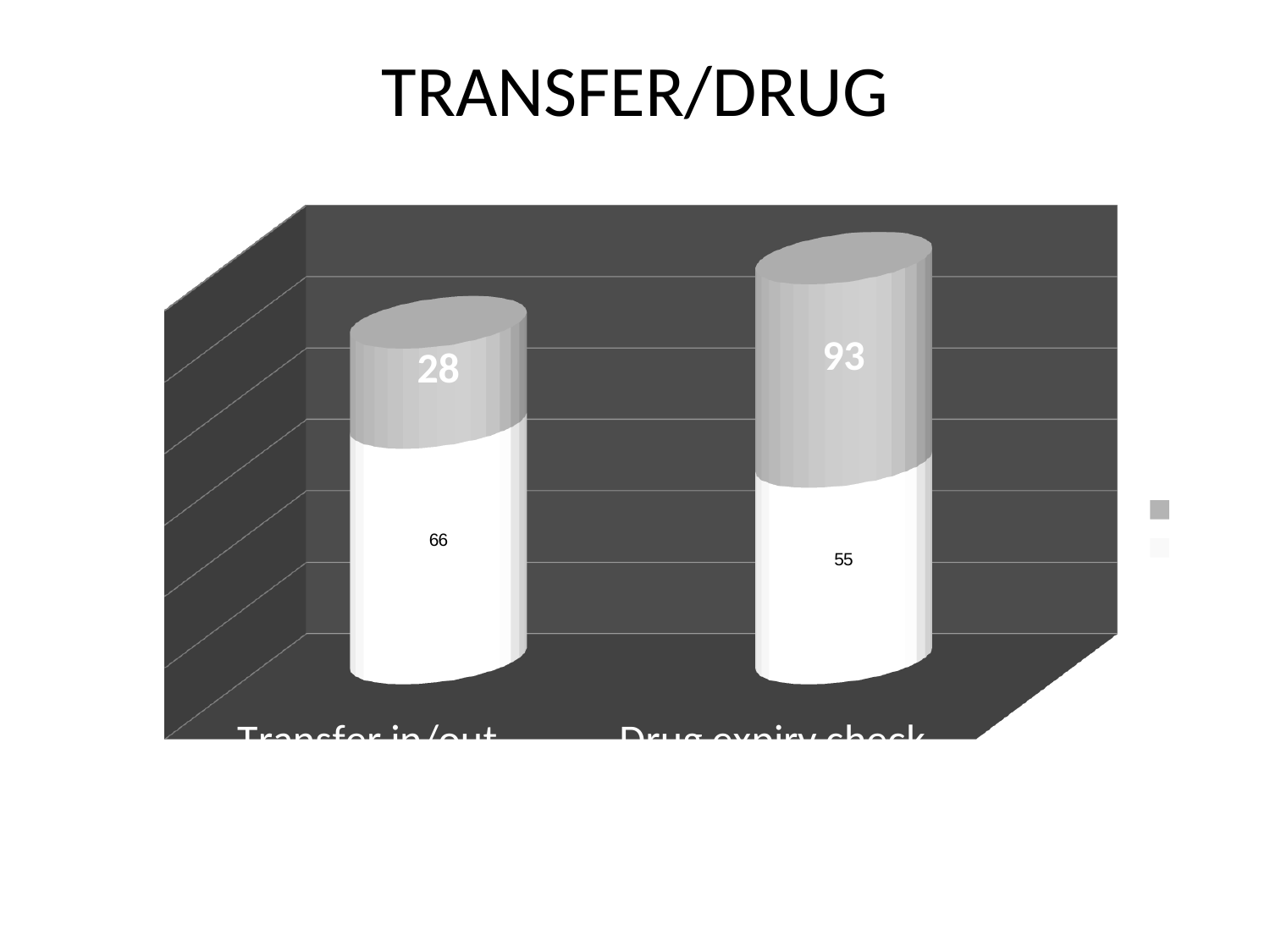
What is the total of the stacked bar for Drug expiry check? 148 Which category has the larger grey (upper) segment value, Transfer in/out or Drug expiry check? Drug expiry check What is the value of the grey (upper) segment for Transfer in/out? 28 How many categories are shown on the x axis? 2 What is the difference between the white segment values for Transfer in/out and Drug expiry check? 11 What is the value of the white (lower) segment for Drug expiry check? 55 What is the total of the stacked bar for Transfer in/out? 94 What is the value of the white (lower) segment for Transfer in/out? 66 What is the difference between the grey segment values for Drug expiry check and Transfer in/out? 65 What is the value of the grey (upper) segment for Drug expiry check? 93 What type of chart is shown on the slide? Stacked bar chart Which category has the tallest stacked bar overall? Drug expiry check